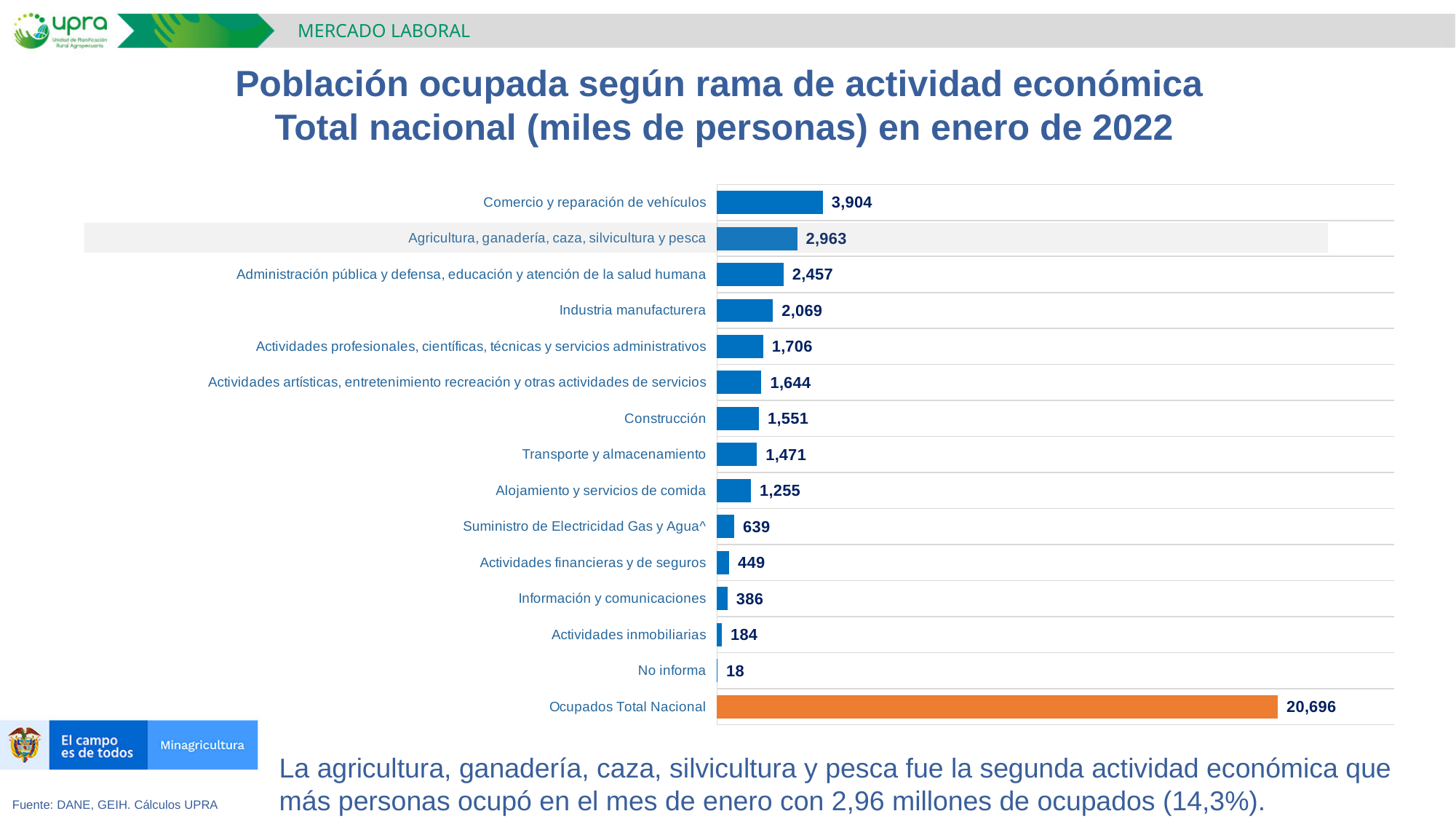
What colour is the bar for Ocupados Total Nacional? Orange What is the difference between Comercio y reparación de vehículos and Agricultura, ganadería, caza, silvicultura y pesca? 941 Which is larger, Construcción or Transporte y almacenamiento? Construcción What is the difference between Administración pública y defensa, educación y atención de la salud humana and Industria manufacturera? 388 What is the value for Comercio y reparación de vehículos? 3,904 What type of chart is shown on the slide? Bar chart How many bars does the chart show? 15 What is the value for Actividades inmobiliarias? 184 Excluding the Ocupados Total Nacional bar, which category has the highest value? Comercio y reparación de vehículos What is the value for Ocupados Total Nacional? 20,696 Which category has the lowest value? No informa What is the value for Agricultura, ganadería, caza, silvicultura y pesca? 2,963